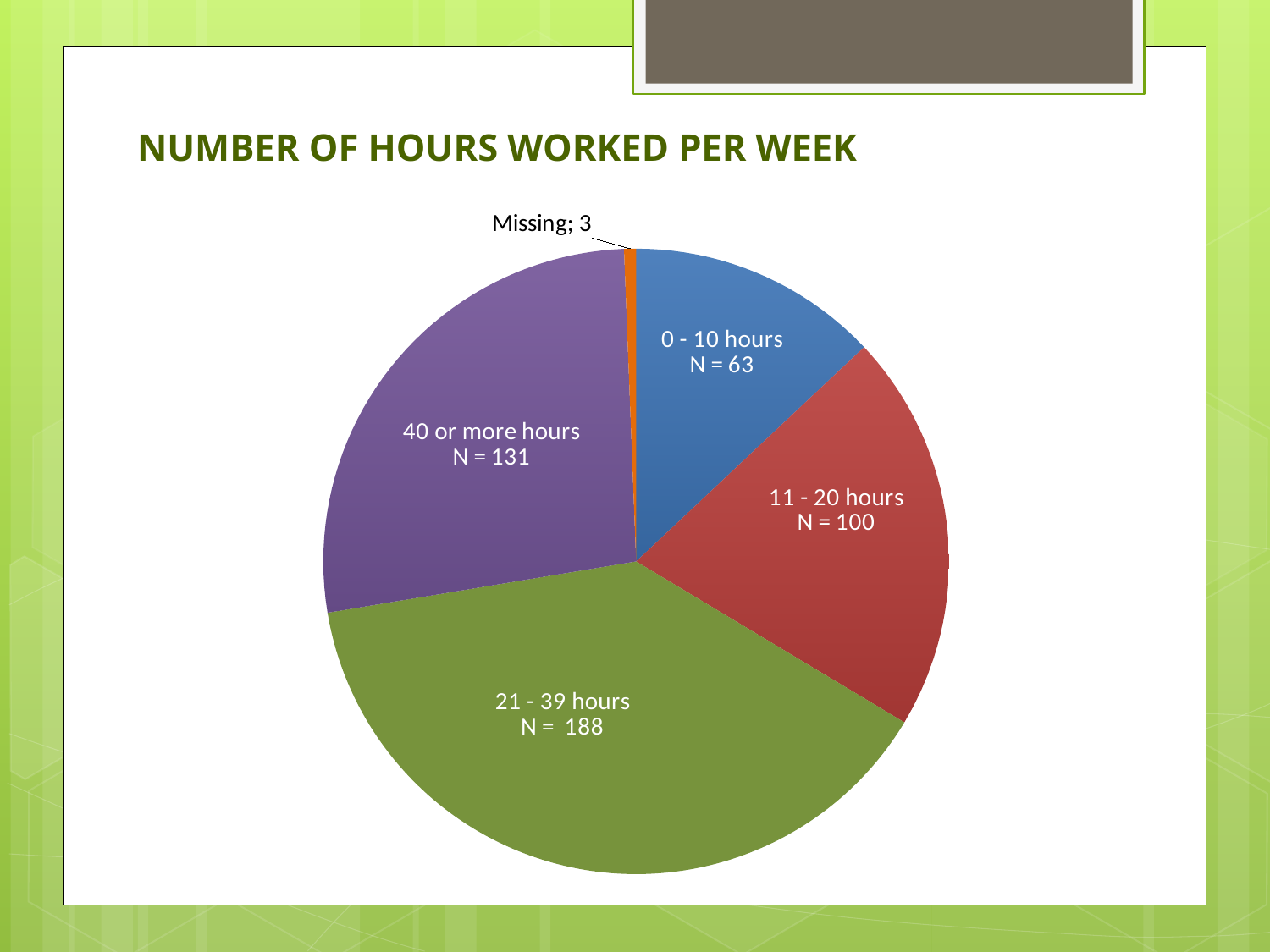
What is the difference between the values for 21 - 39 hours and 40 or more hours? 57 Which category has the smallest slice of the pie? Missing What is the title of the chart? NUMBER OF HOURS WORKED PER WEEK Which category has the largest slice of the pie? 21 - 39 hours How many slices does the pie chart have? 5 What is the value for the Missing slice? 3 What is the total of all the values shown in the pie chart? 485 What is the value for the 21 - 39 hours slice? N = 188 Which is larger, the value for 11 - 20 hours or the value for 0 - 10 hours? 11 - 20 hours What is the value for the 0 - 10 hours slice? N = 63 What is the value for the 40 or more hours slice? N = 131 What kind of chart is shown on the slide? Pie chart